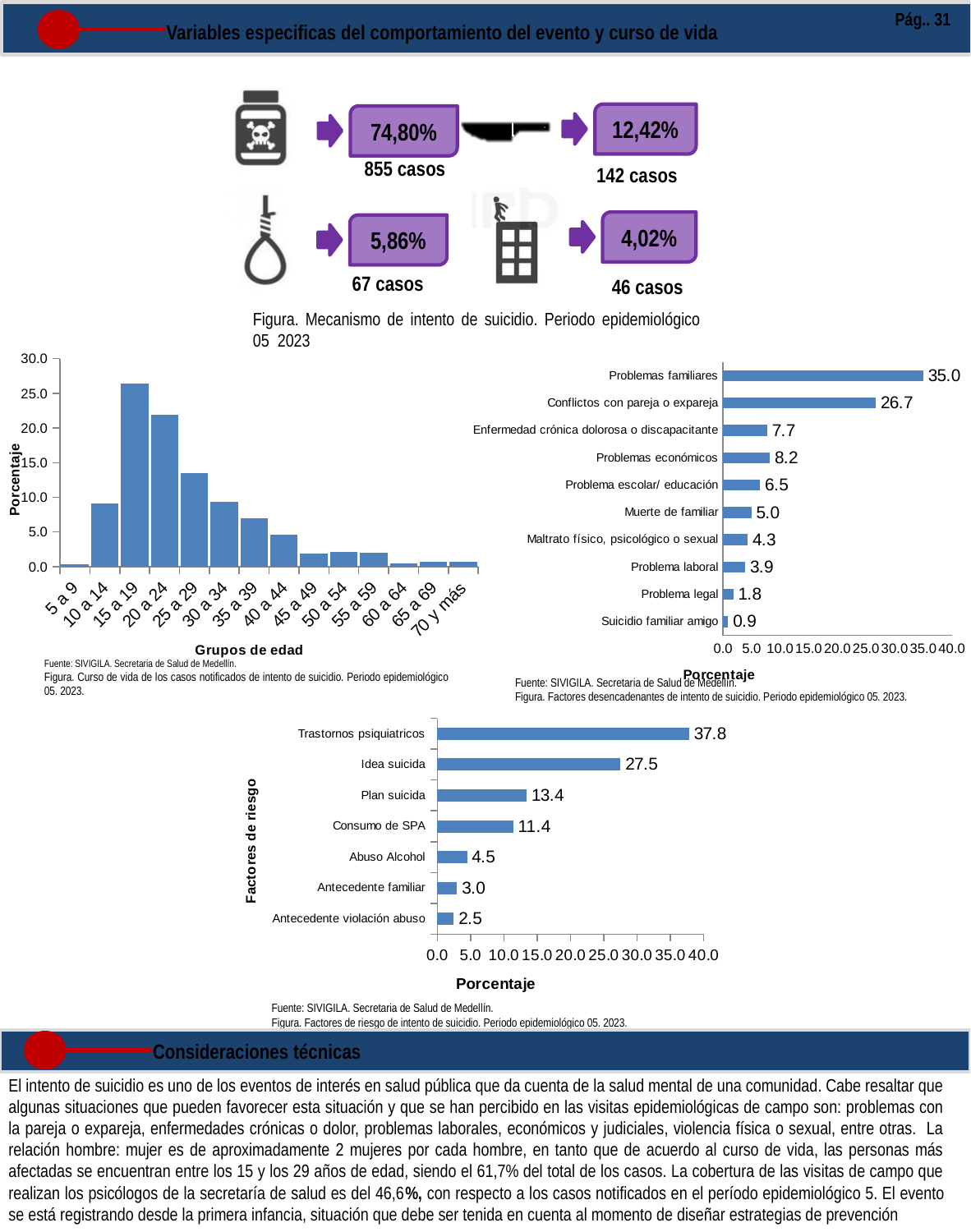
In the 'Grupos de edad' chart (left, middle of the slide), which age group has the highest percentage? 15 a 19 In the 'Grupos de edad' chart (left, middle of the slide), is the value for 20 a 24 greater or less than 20.0? greater In the 'Factores de riesgo' chart (bottom of the slide), what is the value for Consumo de SPA? 11.4 In the 'Factores desencadenantes' chart (right, middle of the slide), what is the value for Problemas familiares? 35.0 What kind of chart is the 'Grupos de edad' chart (left, middle of the slide)? bar chart In the 'Factores desencadenantes' chart (right, middle of the slide), how many categories are shown? 10 In the 'Factores desencadenantes' chart (right, middle of the slide), what is the difference between Problemas familiares and Conflictos con pareja o expareja? 8.3 In the 'Factores de riesgo' chart (bottom of the slide), how many categories are shown? 7 In the 'Factores desencadenantes' chart (right, middle of the slide), which category has the lowest value? Suicidio familiar amigo In the 'Factores de riesgo' chart (bottom of the slide), what is the difference between Trastornos psiquiatricos and Idea suicida? 10.3 In the 'Factores de riesgo' chart (bottom of the slide), which category has the highest value? Trastornos psiquiatricos In the 'Factores desencadenantes' chart (right, middle of the slide), which is larger: Problemas económicos or Enfermedad crónica dolorosa o discapacitante? Problemas económicos